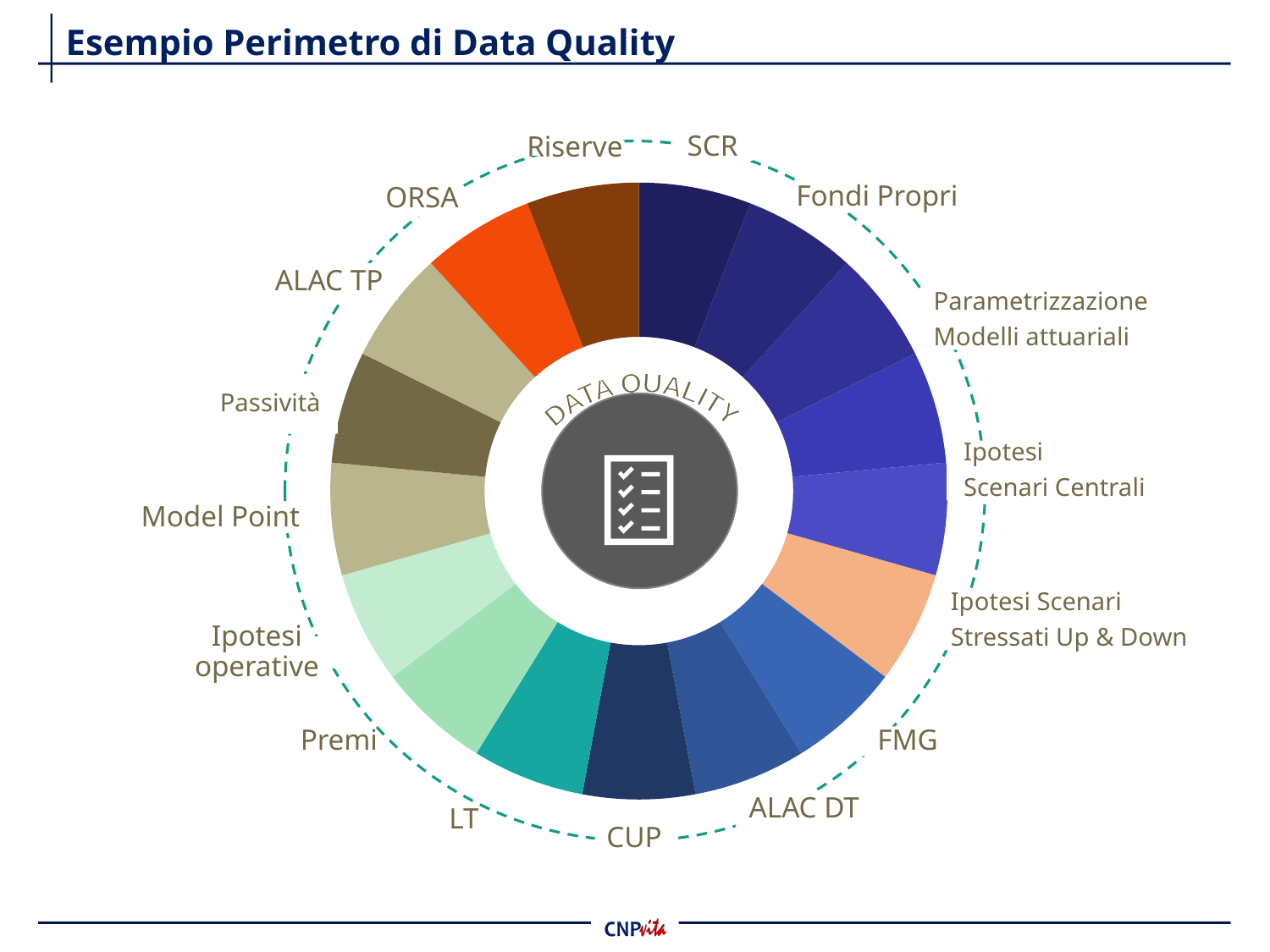
What kind of chart is shown on the slide? Doughnut (pie) chart What text is written in the centre of the doughnut chart? DATA QUALITY Does the chart display any numeric data labels for its segments? No What is the title of the slide containing the chart? Esempio Perimetro di Data Quality